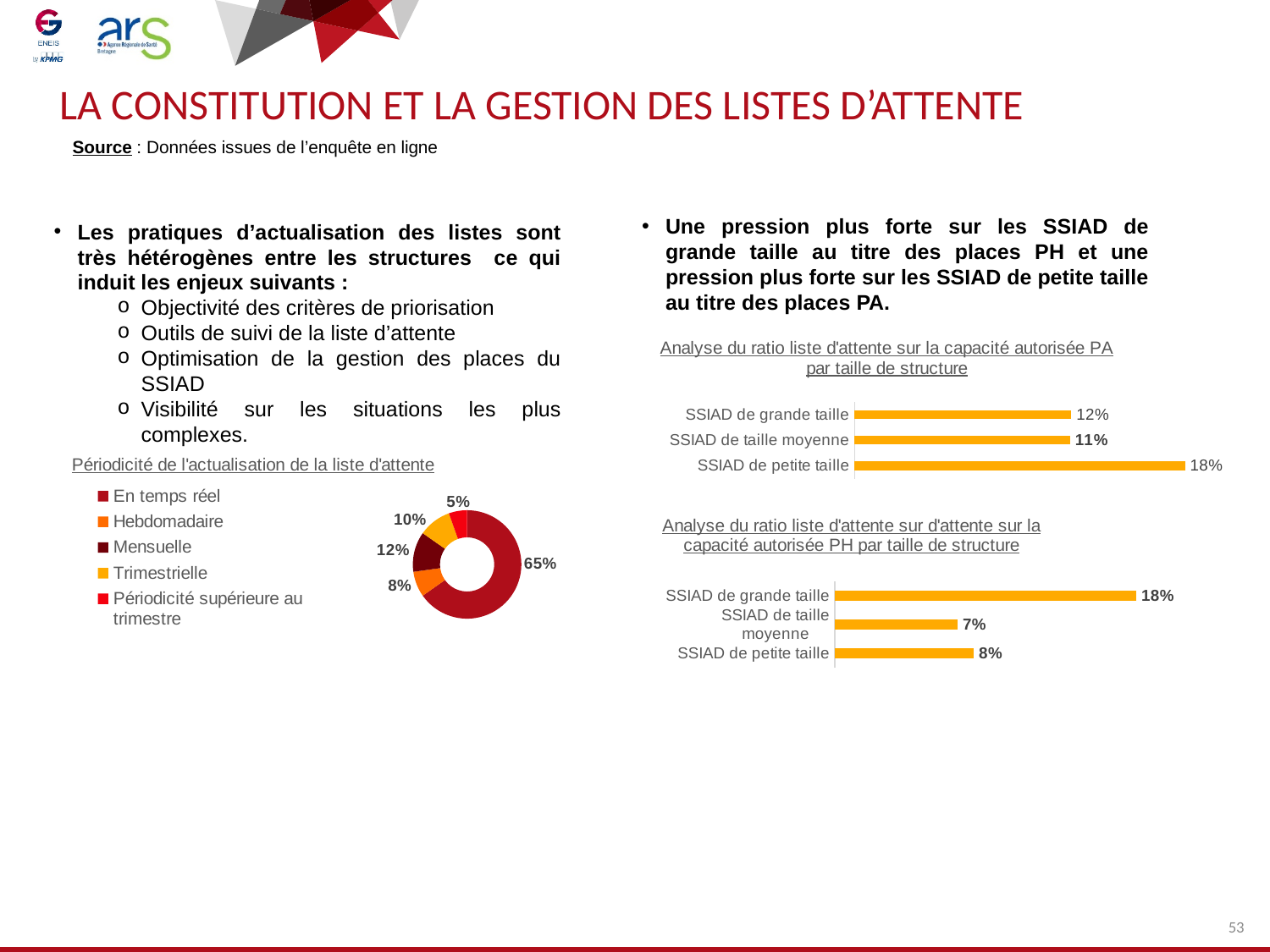
In the PH chart (bottom right), is the value for SSIAD de grande taille larger or smaller than the value for SSIAD de petite taille? larger How many categories are shown in the PH chart (bottom right)? 3 In the PH chart (bottom right), which category has the lowest value? SSIAD de taille moyenne In the chart 'Analyse du ratio liste d'attente sur la capacité autorisée PA par taille de structure', what is the value for SSIAD de petite taille? 18% In the chart 'Périodicité de l'actualisation de la liste d'attente', what is the share of the largest slice? 65% In the chart 'Analyse du ratio liste d'attente sur la capacité autorisée PA par taille de structure', what is the value for SSIAD de taille moyenne? 11% What kind of chart is 'Analyse du ratio liste d'attente sur la capacité autorisée PA par taille de structure'? bar chart In the chart 'Analyse du ratio liste d'attente sur la capacité autorisée PA par taille de structure', which category has the highest value? SSIAD de petite taille In the chart 'Analyse du ratio liste d'attente sur la capacité autorisée PA par taille de structure', what is the difference between SSIAD de petite taille and SSIAD de grande taille? 6% How many entries does the legend of the chart 'Périodicité de l'actualisation de la liste d'attente' list? 5 In the PH chart (bottom right), what is the value for SSIAD de grande taille? 18% In the PH chart (bottom right), what is the difference between SSIAD de petite taille and SSIAD de taille moyenne? 1%